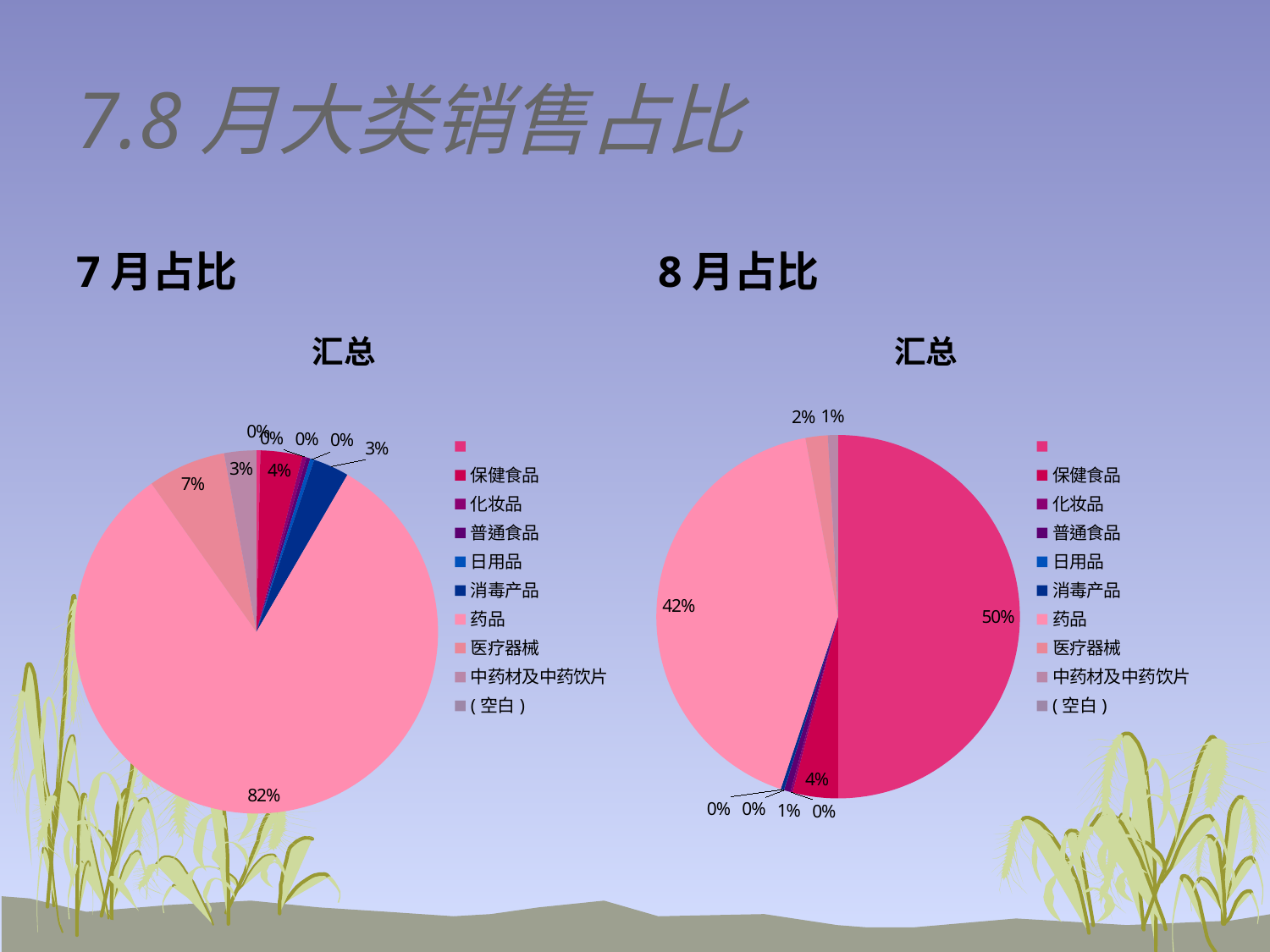
By how many percentage points is the 药品 share in the 7月占比 chart larger than in the 8月占比 chart? 40 percentage points In the 8月占比 pie chart, what share does 药品 have? 42% In the 8月占比 pie chart, what share does 医疗器械 have? 2% In the 7月占比 pie chart, which category has the largest slice? 药品 What kind of charts are shown on the slide? Pie charts In the 7月占比 pie chart, what share does 药品 have? 82% In the 7月占比 pie chart, what share does 医疗器械 have? 7% What title appears above each of the two pie charts? 汇总 In the 8月占比 pie chart, what share does 保健食品 have? 4% In the 7月占比 pie chart, what share does 保健食品 have? 4% In the 8月占比 pie chart, what is the value of the largest slice? 50% In the 7月占比 pie chart, which is larger, the share of 医疗器械 or the share of 保健食品? 医疗器械